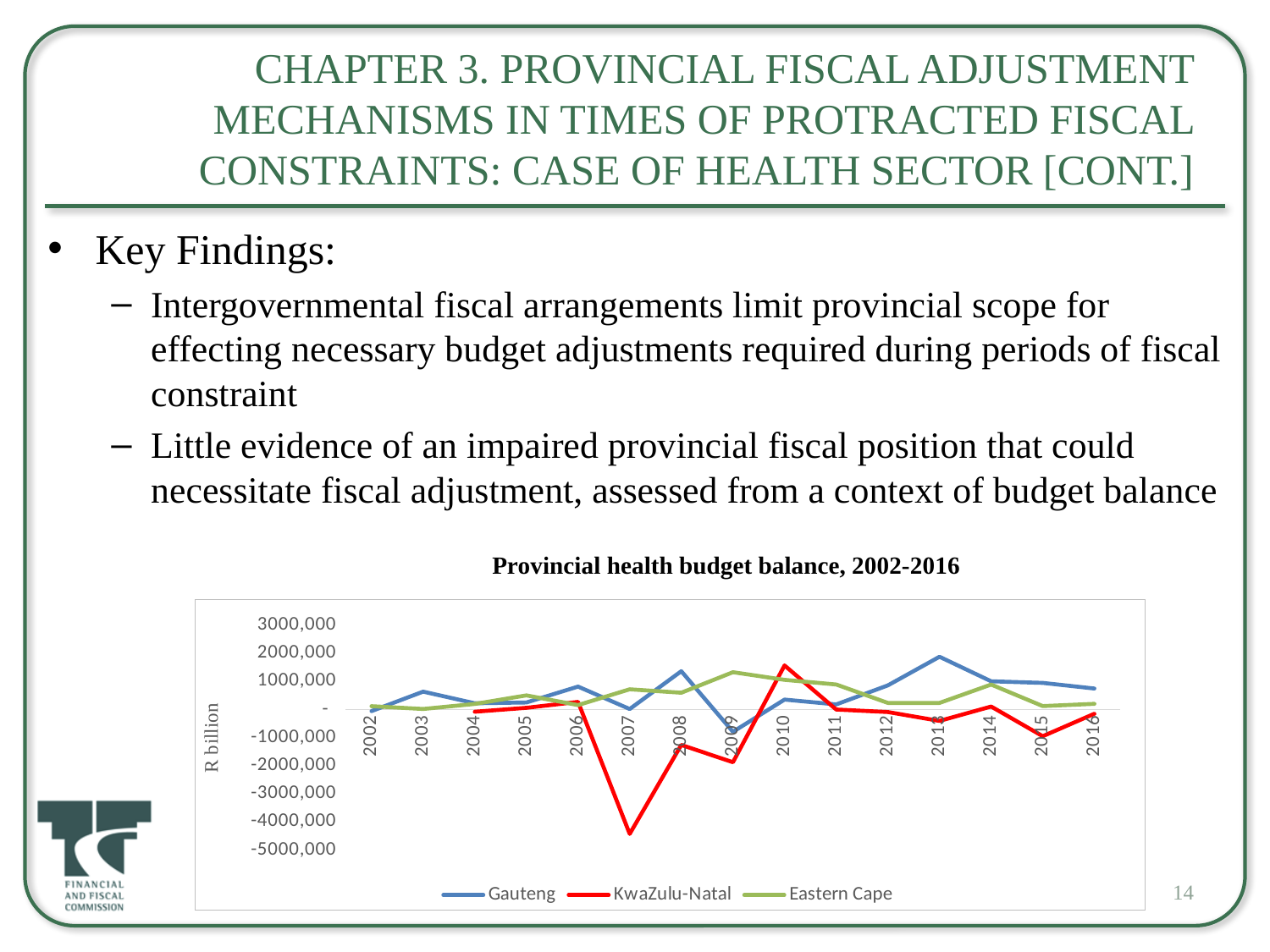
Is the value for KwaZulu-Natal in 2007 greater or less than -4000,000? less How many series does the legend of the chart list? 3 Is the value for Gauteng in 2013 greater or less than 1000,000? greater What is the title of the chart? Provincial health budget balance, 2002-2016 What kind of chart is shown on the slide? Line chart How many years are plotted along the x axis of the chart? 15 Which series has the lowest point anywhere on the chart? KwaZulu-Natal In which year does the KwaZulu-Natal line reach its lowest value? 2007 Is the value for KwaZulu-Natal in 2009 greater or less than -1000,000? less What is the label on the vertical axis of the chart? R billion In which year does the Gauteng line reach its highest value? 2013 In 2007, which is larger: the value for Gauteng or the value for KwaZulu-Natal? Gauteng